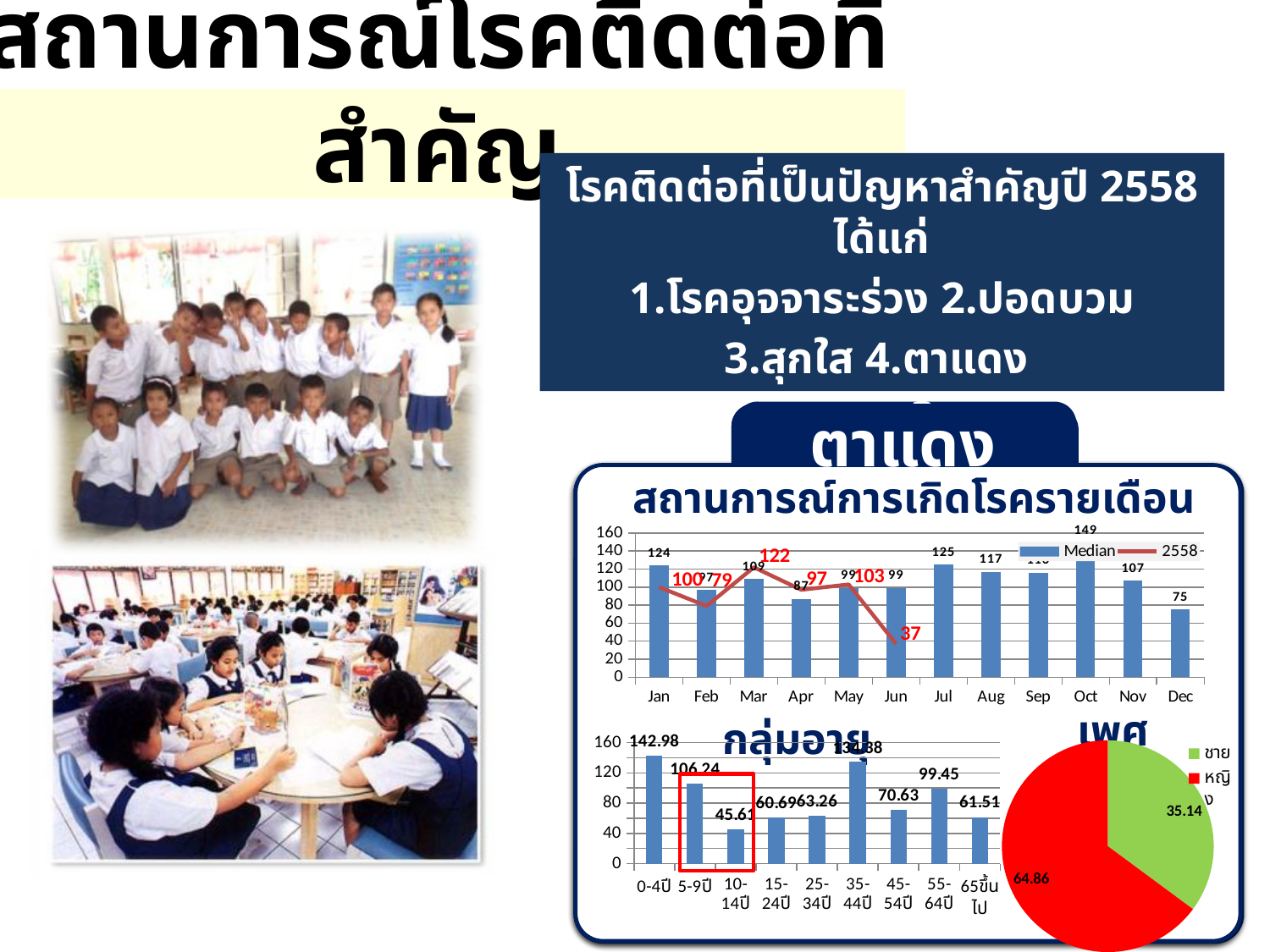
In the monthly chart titled สถานการณ์การเกิดโรครายเดือน, which is larger for Mar: the Median value or the 2558 value? 2558 In the pie chart titled เพศ, what is the value for หญิง? 64.86 In the monthly chart titled สถานการณ์การเกิดโรครายเดือน, what is the difference between the Median value for Jul and the Median value for Dec? 50 How many series does the legend of the monthly chart titled สถานการณ์การเกิดโรครายเดือน list? 2 In the monthly chart titled สถานการณ์การเกิดโรครายเดือน, what is the Median value for Jan? 124 In the monthly chart titled สถานการณ์การเกิดโรครายเดือน, which month has the lowest Median value? Dec In the age-group chart titled กลุ่มอายุ, what is the value for 0-4ปี? 142.98 How many age groups are shown in the chart titled กลุ่มอายุ? 9 What kind of chart is the chart titled เพศ? pie chart In the age-group chart titled กลุ่มอายุ, which age group has the lowest value? 10-14ปี In the monthly chart titled สถานการณ์การเกิดโรครายเดือน, which month has the highest Median value? Oct In the monthly chart titled สถานการณ์การเกิดโรครายเดือน, what is the 2558 value for Jun? 37